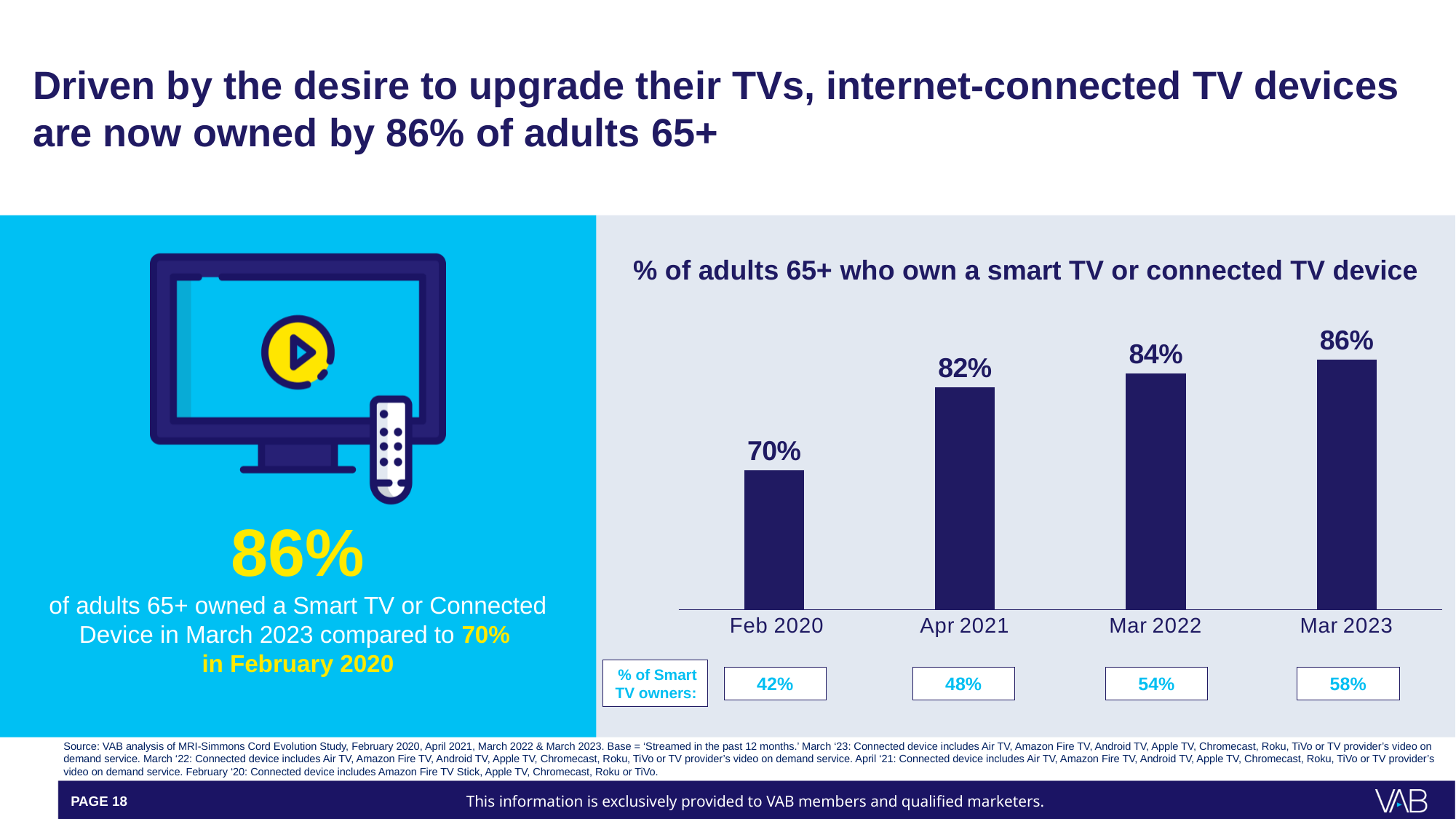
Which period has the highest value in the chart? Mar 2023 What is the value for Mar 2023 in the chart? 86% What is the difference between the Mar 2023 value and the Feb 2020 value? 16% Do the values rise or fall from Feb 2020 to Mar 2023? Rise What is the title of the chart? % of adults 65+ who own a smart TV or connected TV device What kind of chart is shown on the slide? Bar chart What is the value for Feb 2020 in the chart? 70% Which is larger, the value for Apr 2021 or the value for Mar 2022? Mar 2022 What is the value for Apr 2021 in the chart? 82% What is the value for Mar 2022 in the chart? 84% How many periods are shown in the chart? 4 Which period has the lowest value in the chart? Feb 2020